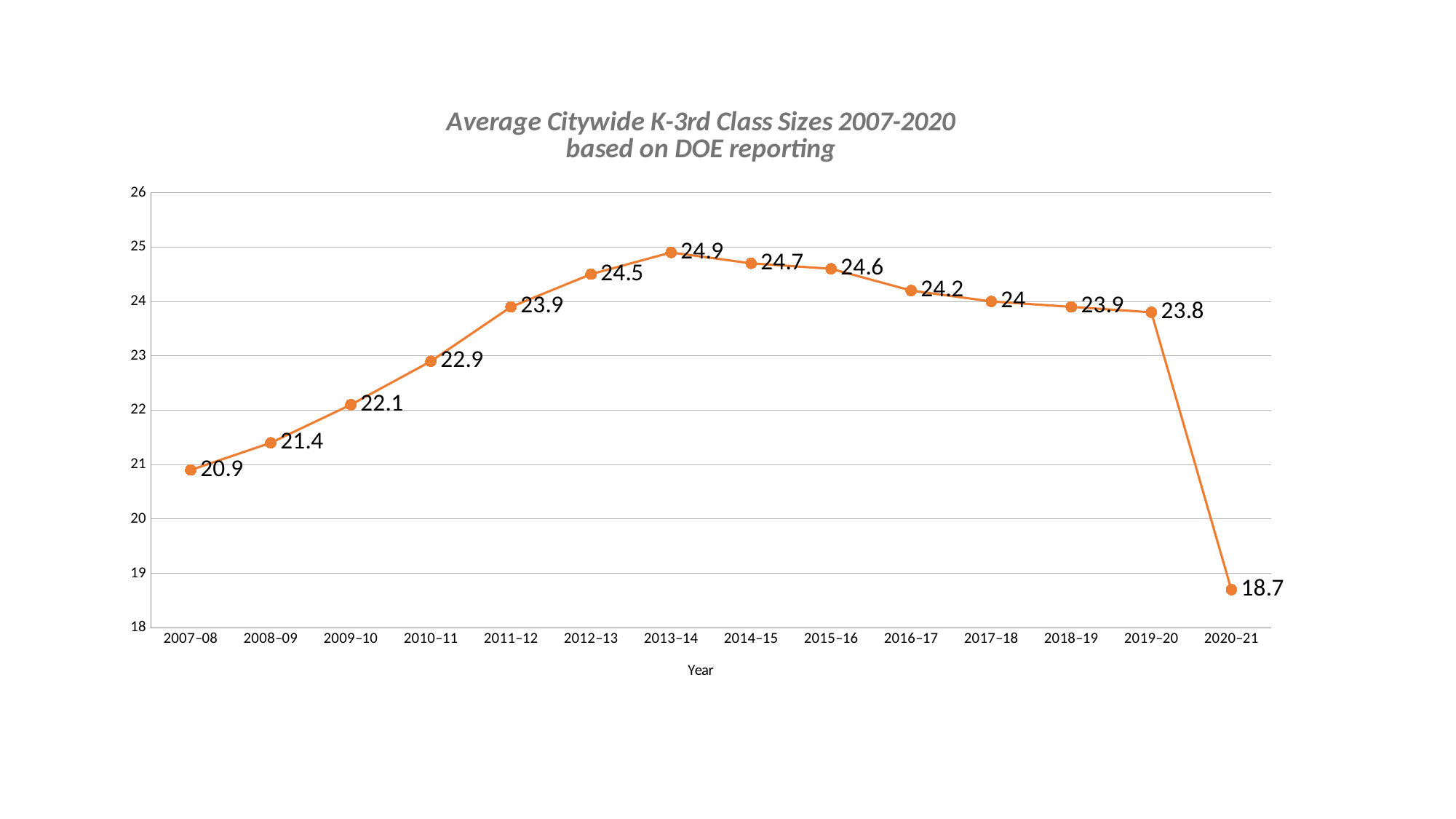
Which year has a larger average class size, 2010–11 or 2016–17? 2016–17 What kind of chart is shown? line chart What is the average class size for 2007–08? 20.9 Which year has the lowest average class size? 2020–21 Which year has the highest average class size? 2013–14 What is the average class size for 2020–21? 18.7 What is the difference between the class sizes for 2019–20 and 2020–21? 5.1 Do the values rise or fall from 2007–08 to 2013–14? rise What is the average class size for 2013–14? 24.9 Is the value for 2011–12 greater or less than 23? greater How many years are plotted on the chart? 14 What is the label on the x axis? Year